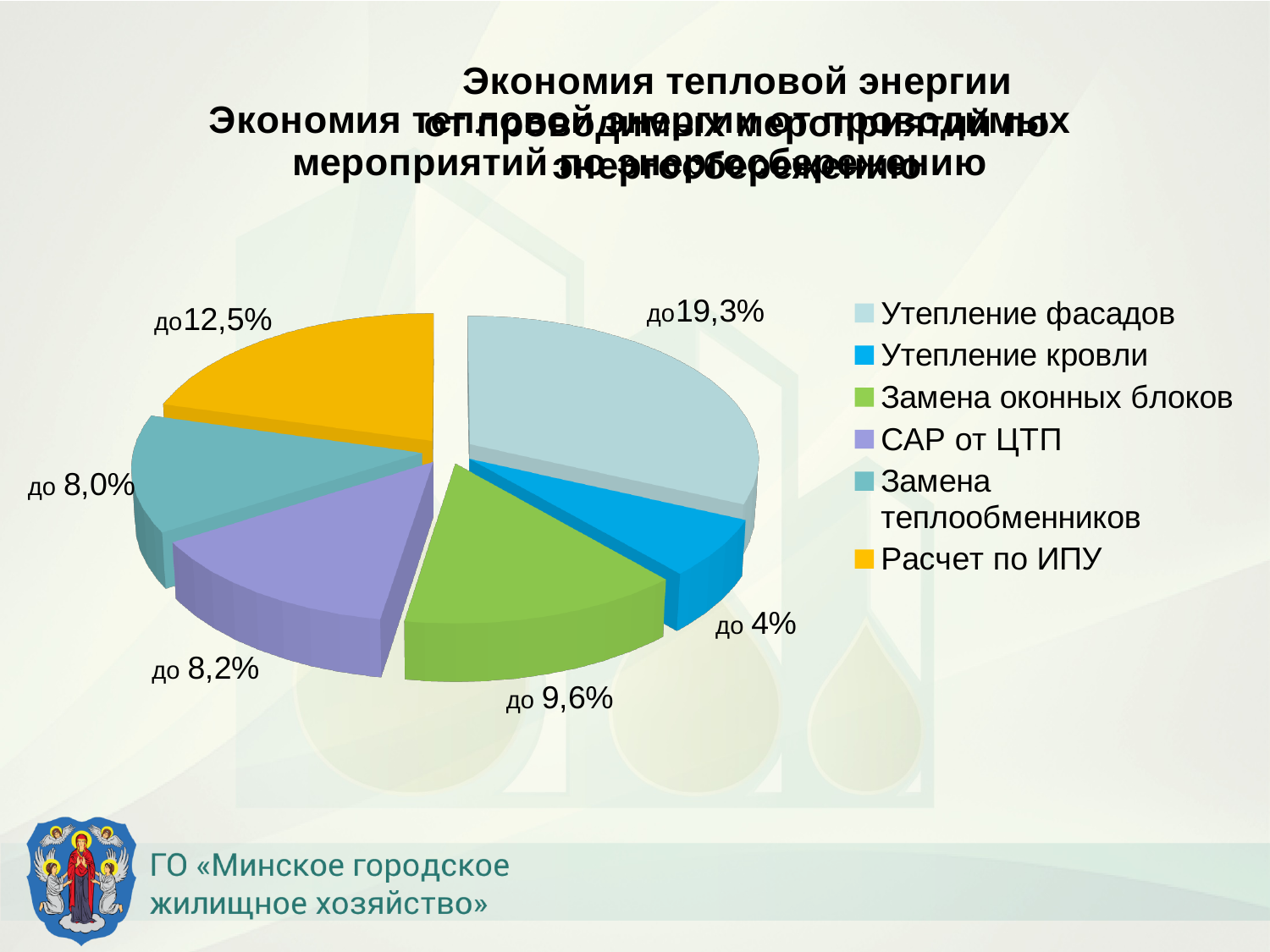
How many entries does the legend list? 6 Which category has the smallest slice of the pie? Утепление кровли What kind of chart is shown on the slide? pie chart What colour is the Расчет по ИПУ slice? yellow How many slices does the pie chart have? 6 Which slice is larger: Расчет по ИПУ or Замена оконных блоков? Расчет по ИПУ What value is shown for the САР от ЦТП slice? до 8,2% What value is shown for the Утепление фасадов slice? до19,3% What value is shown for the Расчет по ИПУ slice? до12,5% What value is shown for the Утепление кровли slice? до 4% Which category has the largest slice of the pie? Утепление фасадов What value is shown for the Замена оконных блоков slice? до 9,6%